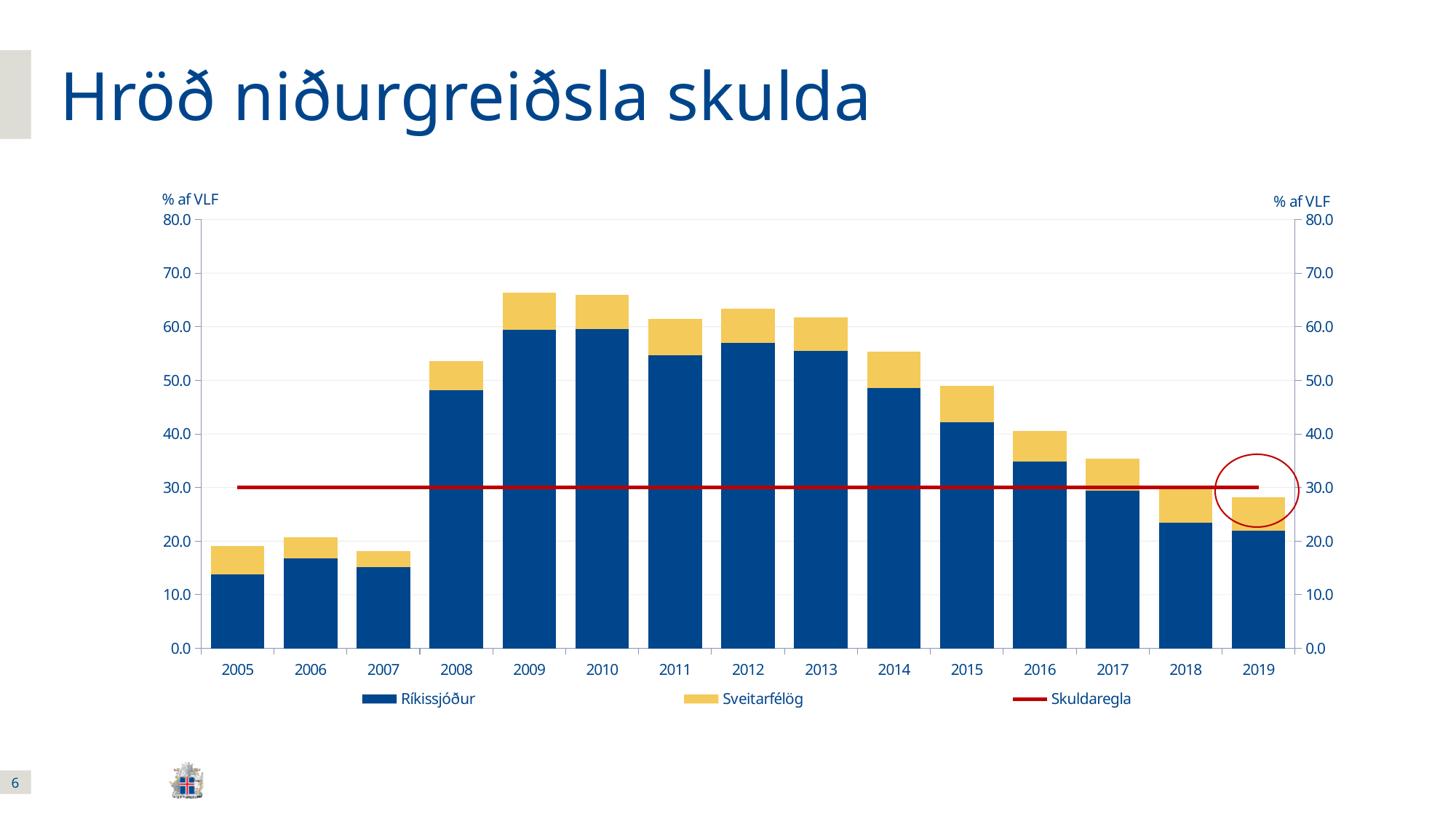
How many entries does the chart's legend list? 3 How many years are shown on the x axis of the chart? 15 Is the total stacked value for 2017 greater or less than 30.0? greater Which year has the larger total stacked value, 2007 or 2008? 2008 What kind of chart is shown on the slide? Stacked bar chart with a line (combination bar and line chart) At what level (% af VLF) is the Skuldaregla line drawn? 30.0 Do the total stacked values rise or fall from 2010 to 2019? fall Is the Ríkissjóður value for 2016 greater or less than 30.0? greater Which year's bar is highlighted with a red circle? 2019 Which year has the larger total stacked value, 2014 or 2015? 2014 Is the total stacked value for 2019 greater or less than 30.0? less